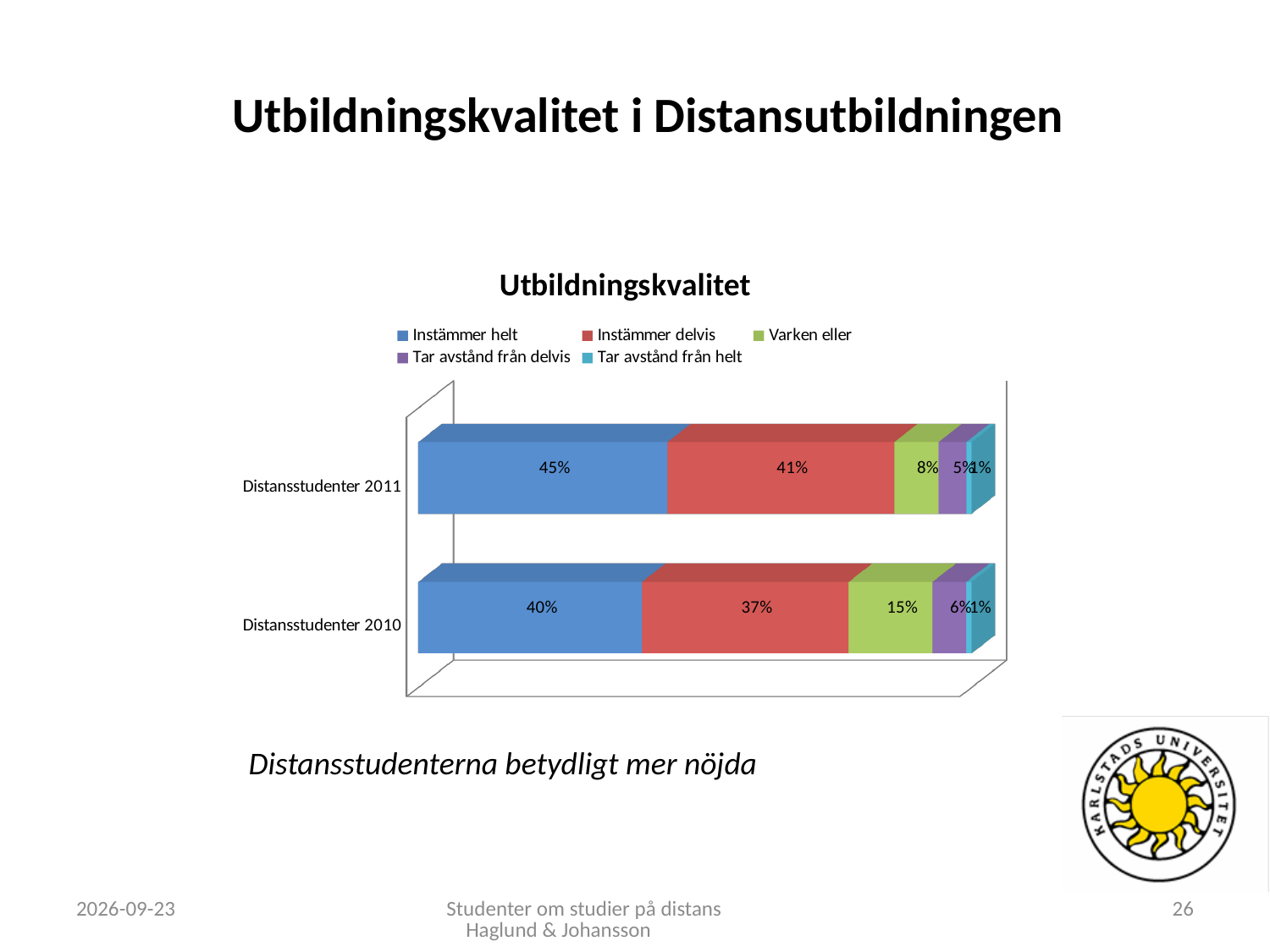
Which category has the higher value for 'Instämmer helt', Distansstudenter 2011 or Distansstudenter 2010? Distansstudenter 2011 What is the title of the chart? Utbildningskvalitet Which series has the lowest value for Distansstudenter 2010? Tar avstånd från helt What is the value of 'Tar avstånd från delvis' for Distansstudenter 2011? 5% What is the total of the stacked bar for Distansstudenter 2011? 100% How many series does the chart legend list? 5 What is the value of 'Varken eller' for Distansstudenter 2010? 15% What is the value of 'Instämmer helt' for Distansstudenter 2011? 45% What is the value of 'Instämmer delvis' for Distansstudenter 2010? 37% How many categories (bars) are shown in the chart? 2 What kind of chart is shown on the slide? Stacked bar chart What is the difference between the 'Varken eller' values for Distansstudenter 2010 and Distansstudenter 2011? 7%